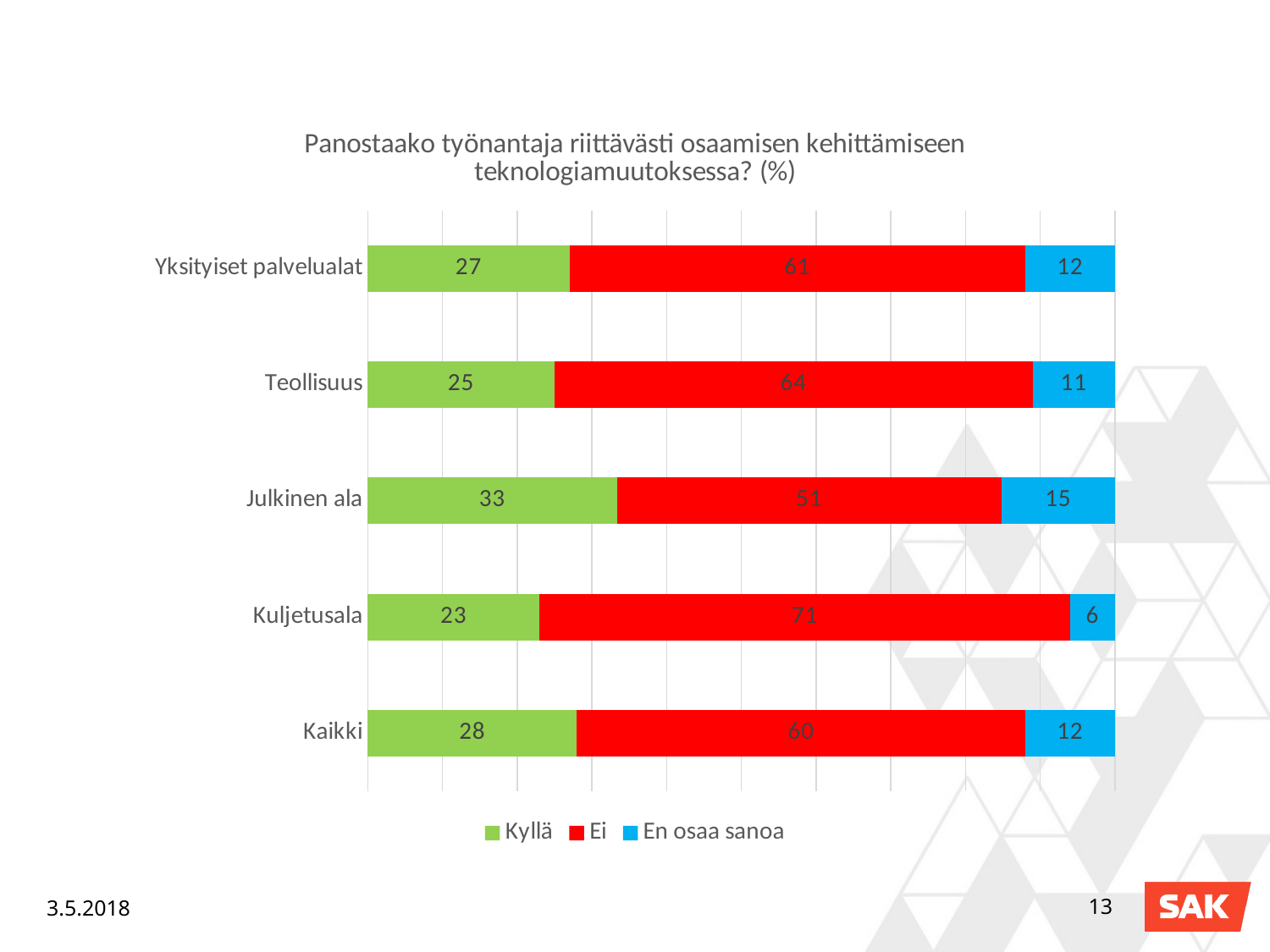
What is the "En osaa sanoa" value for Teollisuus? 11 Which category has the lowest "En osaa sanoa" value? Kuljetusala What is the total of the stacked bar for Kaikki? 100 What is the difference between the "Ei" values for Kuljetusala and Julkinen ala? 20 Which is larger: the "Kyllä" value for Yksityiset palvelualat or for Teollisuus? Yksityiset palvelualat Which category has the highest "Kyllä" value? Julkinen ala What kind of chart is shown on the slide? Stacked bar chart How many categories are shown on the chart? 5 How many series does the legend list? 3 What is the "Kyllä" value for Julkinen ala? 33 What is the "Ei" value for Kuljetusala? 71 Which category has the highest "Ei" value? Kuljetusala